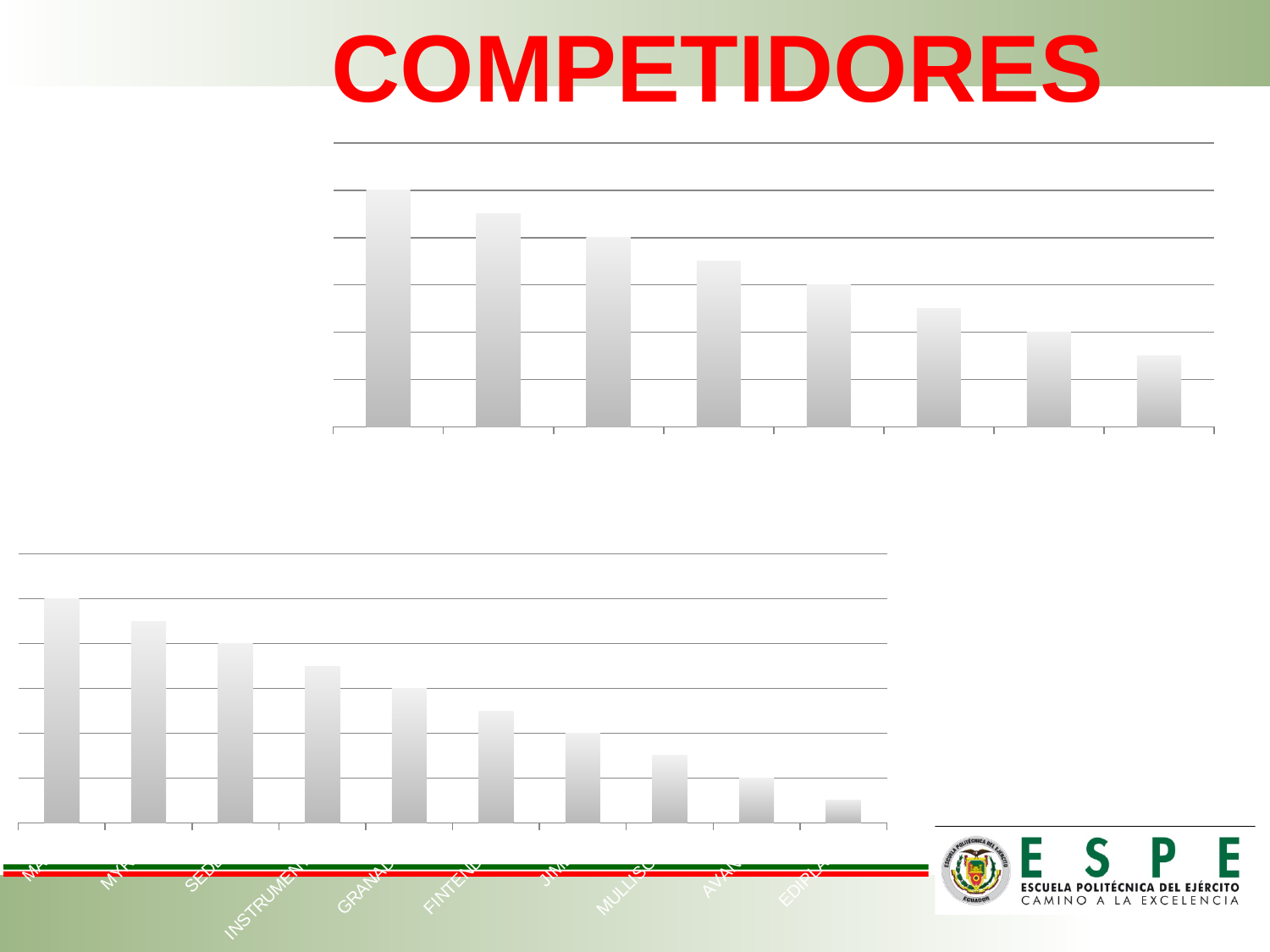
In the bottom chart, which is taller, the first bar or the fifth bar? the first bar In the top chart, do the bar heights rise or fall from left to right? fall How many bars does the top chart have? 8 How many bars does the bottom chart have? 10 What kind of chart is the top chart on the slide? bar chart What kind of chart is the bottom chart on the slide? bar chart In the bottom chart, which bar is the tallest? the first (leftmost) bar In the top chart, which bar is the shortest? the last (rightmost) bar In the top chart, which bar is the tallest? the first (leftmost) bar In the bottom chart, do the bar heights rise or fall from left to right? fall What is the title of the slide? COMPETIDORES In the bottom chart, which bar is the shortest? the last (rightmost) bar